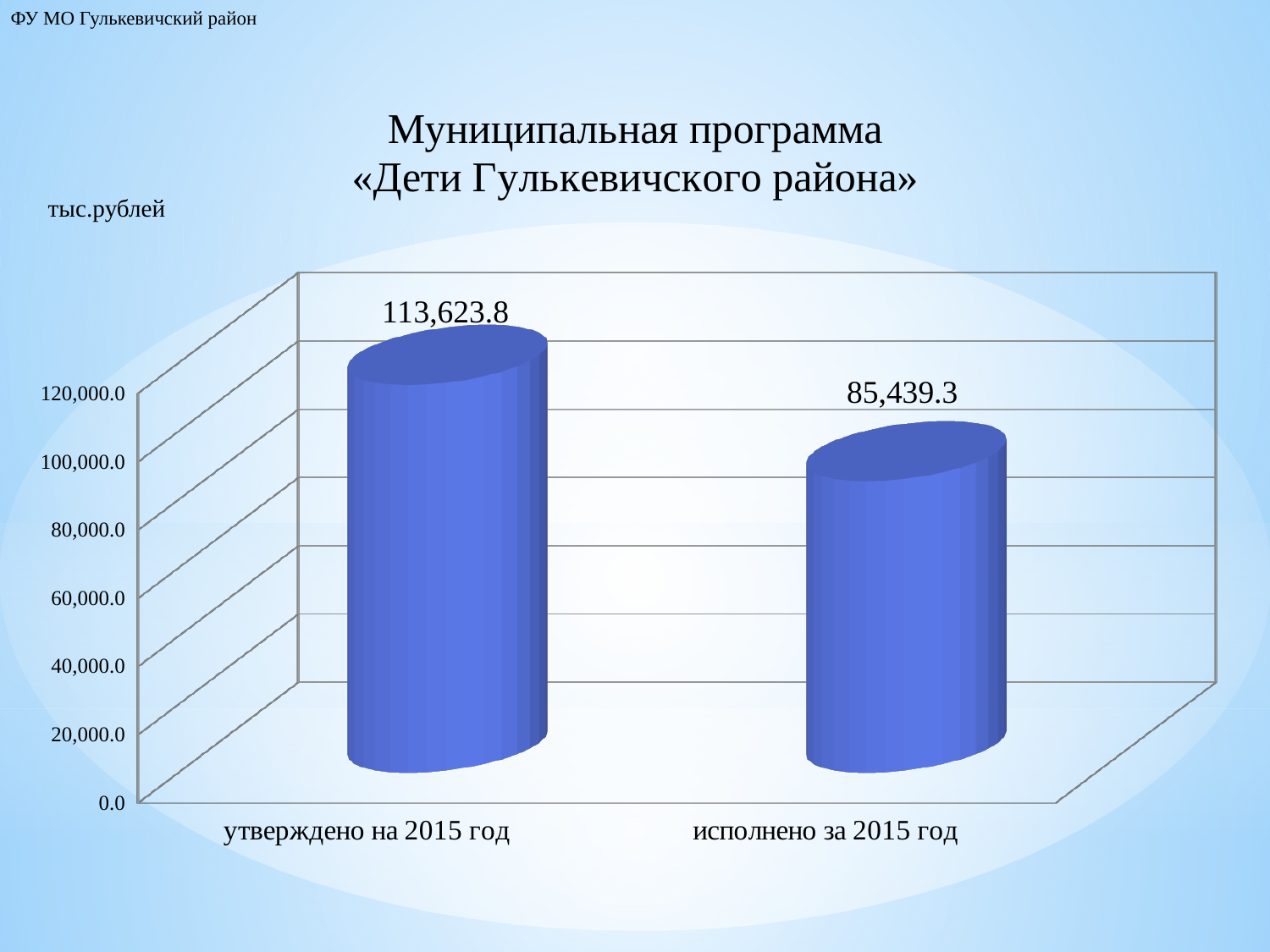
What is the value for «исполнено за 2015 год»? 85,439.3 Is the value for «исполнено за 2015 год» greater or less than 100,000.0? less Which is larger: the value for «утверждено на 2015 год» or the value for «исполнено за 2015 год»? утверждено на 2015 год How many categories are shown on the chart? 2 What is the title of the chart? Муниципальная программа «Дети Гулькевичского района» Which category has the highest value? утверждено на 2015 год What unit is indicated for the values on the chart? тыс.рублей What is the value for «утверждено на 2015 год»? 113,623.8 What kind of chart is shown on the slide? bar chart Which category has the lowest value? исполнено за 2015 год Is the value for «утверждено на 2015 год» greater or less than 100,000.0? greater What is the difference between the value for «утверждено на 2015 год» and the value for «исполнено за 2015 год»? 28,184.5